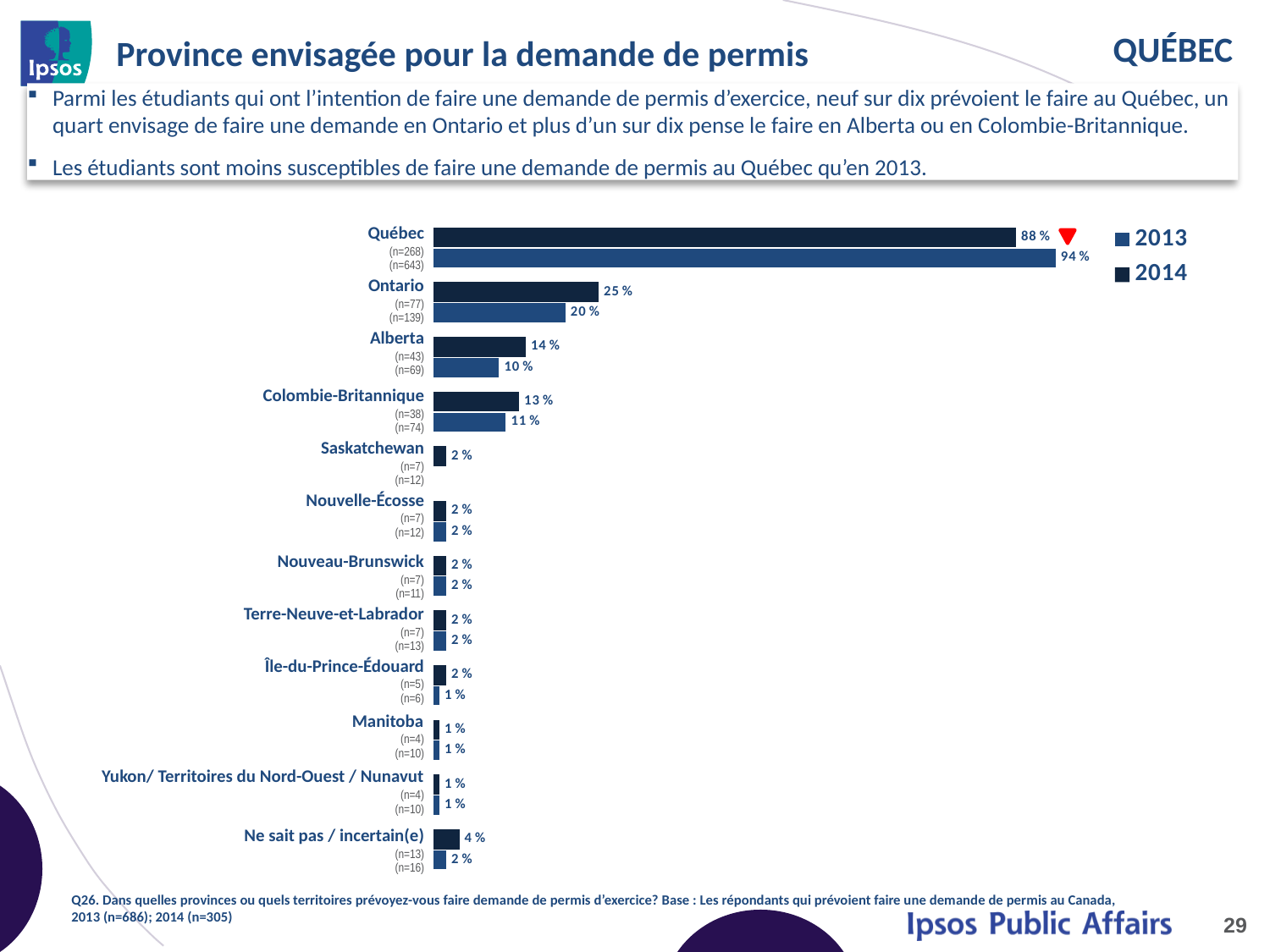
What is the difference between the two Québec values (94 % and 88 %)? 6 % Which category has the highest values on the chart? Québec What is the value shown on the upper bar for Québec? 88 % What is the value shown on the upper bar for Ontario? 25 % What are the two entries in the chart legend? 2013 and 2014 What is the value shown on the lower bar for Alberta? 10 % What is the value shown on the upper bar for Ne sait pas / incertain(e)? 4 % Which is larger: the upper bar for Alberta or the upper bar for Colombie-Britannique? Alberta What is the value shown on the lower bar for Québec? 94 % What kind of chart is shown on the slide? bar chart How many series does the legend list? 2 How many categories (provinces/territories and other responses) are shown on the chart? 12